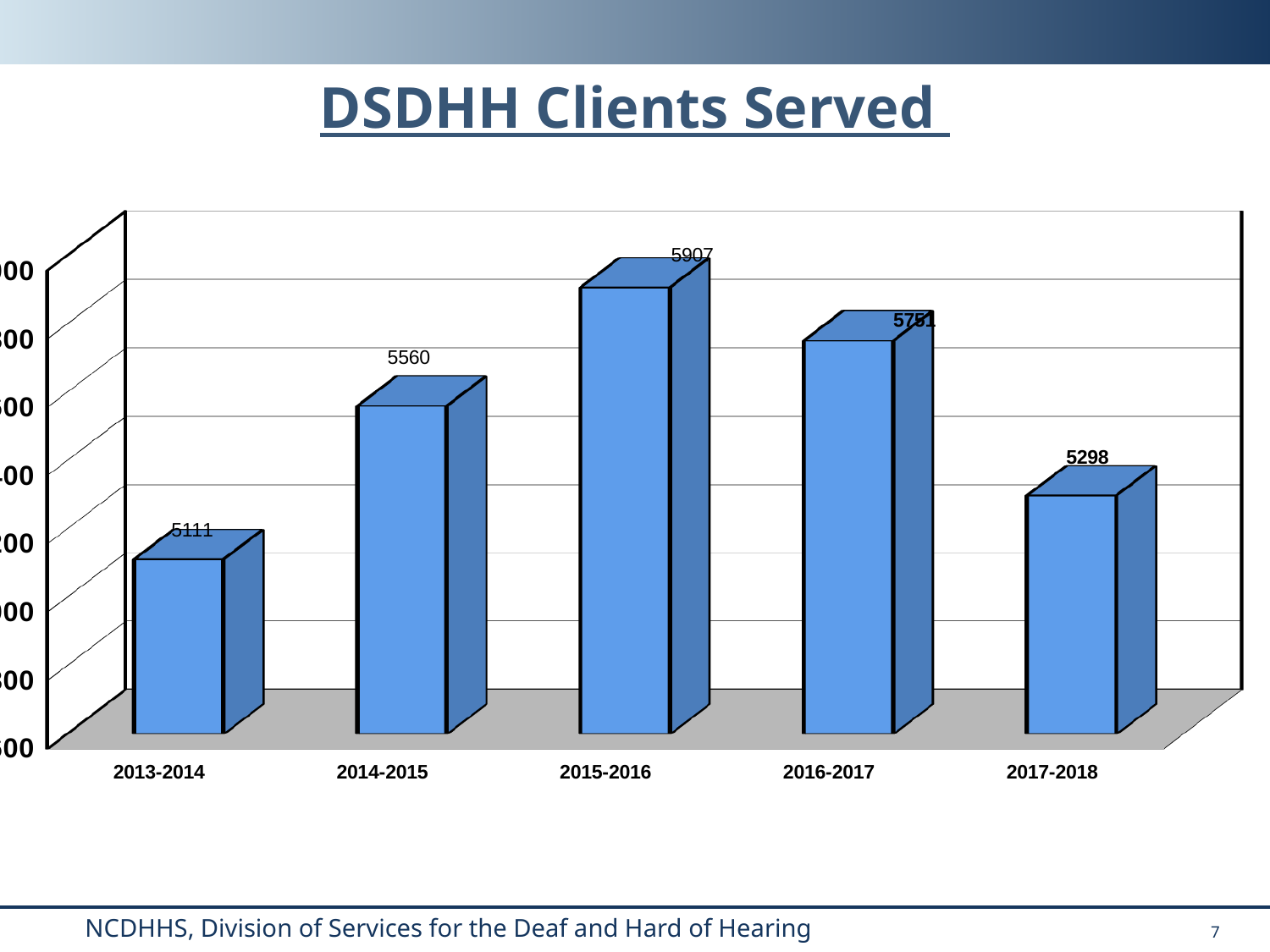
Which year had the highest number of clients served? 2015-2016 Do the values rise or fall from 2013-2014 to 2015-2016? Rise How many clients were served in 2015-2016? 5907 How many years are shown on the x axis? 5 What kind of chart is shown on the slide? Bar chart Which is larger, the value for 2014-2015 or the value for 2017-2018? 2014-2015 What is the value shown for 2014-2015? 5560 How many clients were served in 2013-2014? 5111 Which year had the lowest number of clients served? 2013-2014 What is the difference between the values for 2015-2016 and 2013-2014? 796 What is the value shown for 2017-2018? 5298 By how much did the value increase from 2013-2014 to 2014-2015? 449